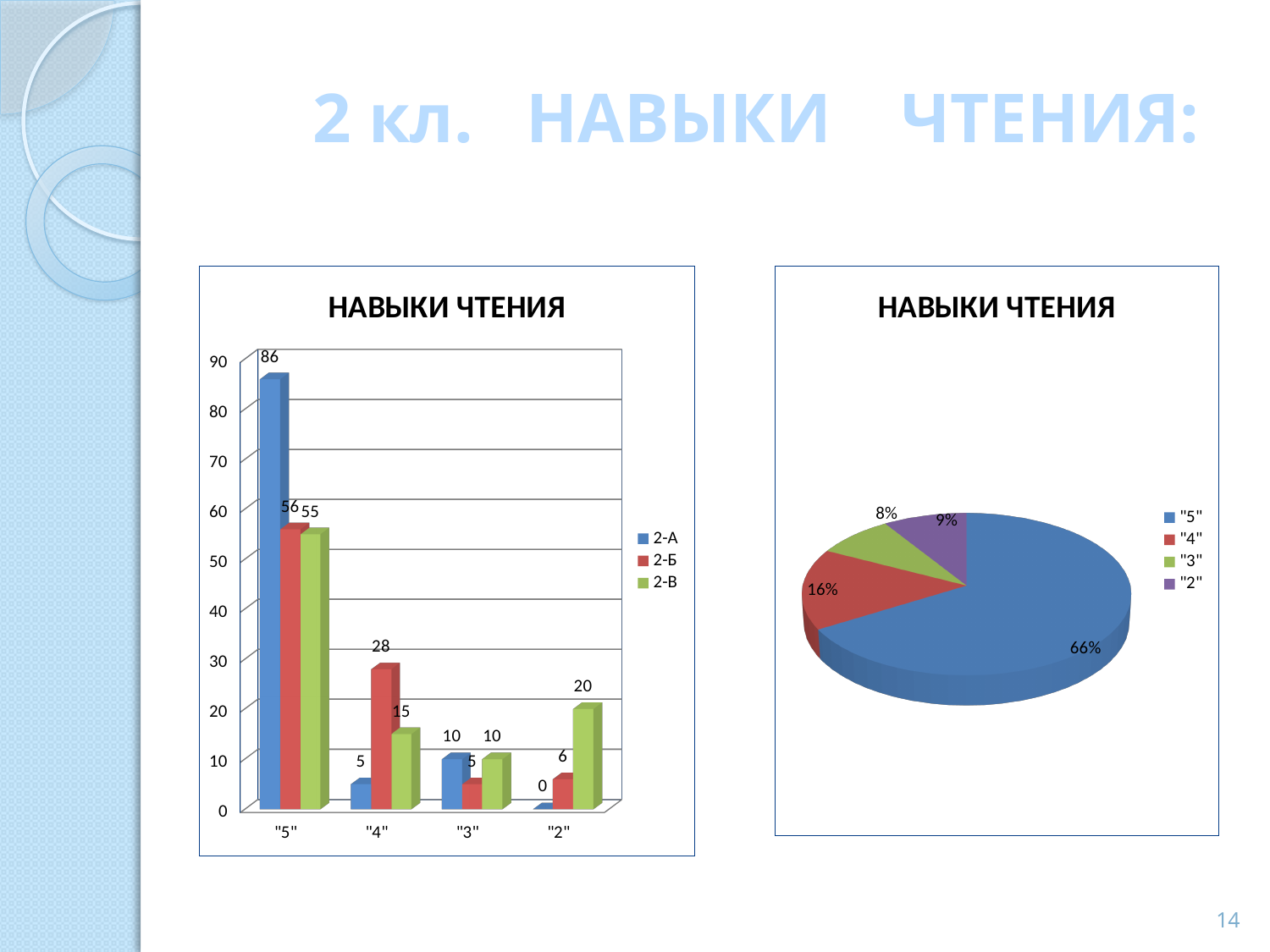
In the bar chart on the left, what is the value for 2-Б in the "4" category? 28 In the pie chart on the right, which slice is the smallest? "3" How many series does the legend of the bar chart on the left list? 3 How many categories are shown on the x axis of the bar chart on the left? 4 In the bar chart on the left, what is the value for 2-А in the "5" category? 86 In the bar chart on the left, which series has the lowest value in the "2" category? 2-А In the pie chart on the right, what share does the "5" slice have? 66% In the bar chart on the left, what is the value for 2-В in the "2" category? 20 What kind of chart is the chart on the right? Pie chart In the bar chart on the left, what is the difference between the 2-Б and 2-В values in the "4" category? 13 In the bar chart on the left, which is larger in the "3" category: 2-А or 2-Б? 2-А In the bar chart on the left, which series has the highest value in the "5" category? 2-А